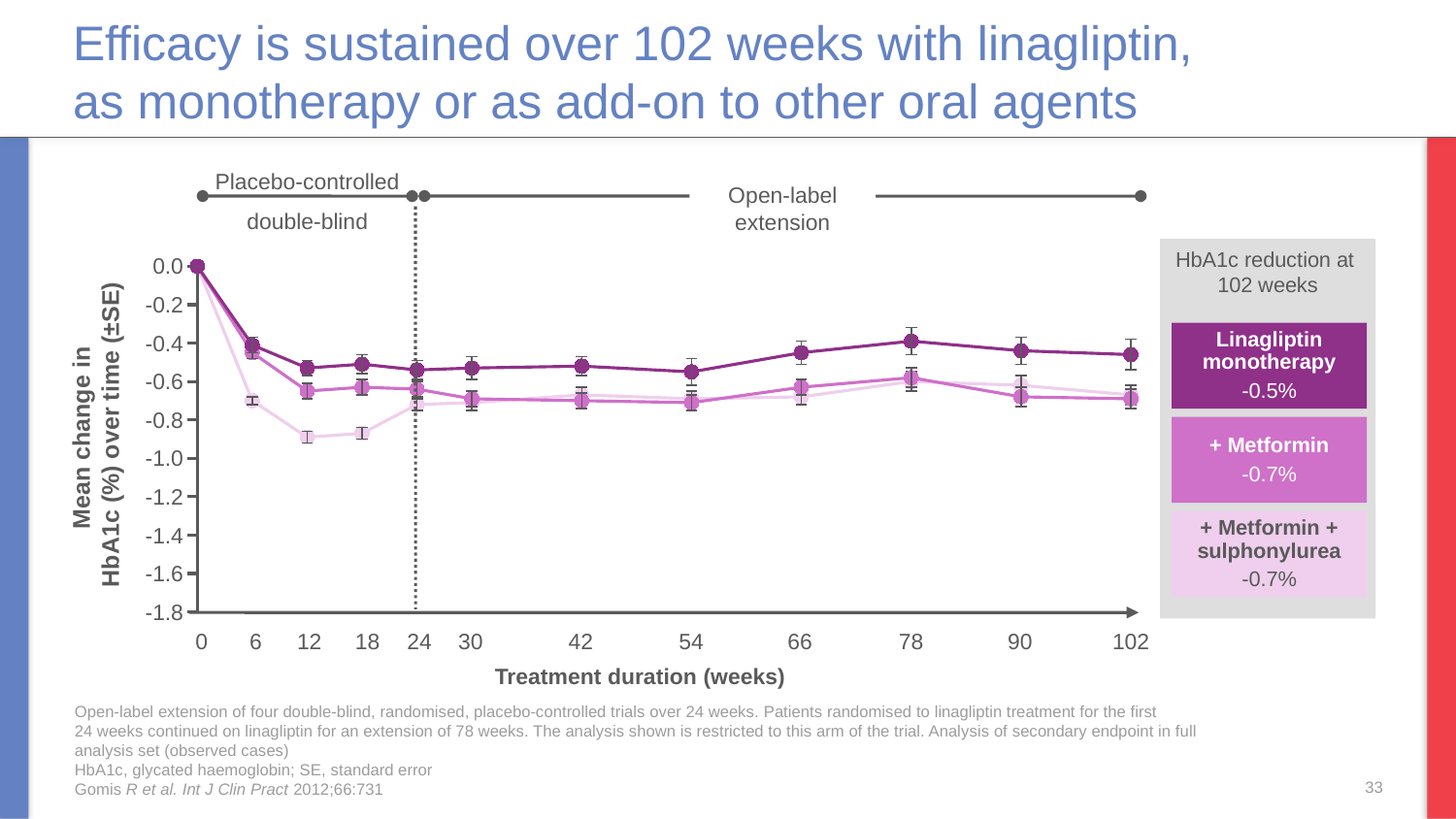
How many treatment series are plotted on the chart? 3 What is the label of the x axis? Treatment duration (weeks) What is the HbA1c reduction at 102 weeks for linagliptin + Metformin + sulphonylurea? -0.7% What is the difference between the HbA1c reduction at 102 weeks for linagliptin monotherapy and for + Metformin? 0.2% What is the HbA1c reduction at 102 weeks for linagliptin monotherapy? -0.5% Between week 0 and week 6, do the plotted values rise or fall? fall At week 12, is the mean change in HbA1c for + Metformin + sulphonylurea greater or less than -0.8? less What kind of chart is shown on the slide? line chart What is the HbA1c reduction at 102 weeks for linagliptin + Metformin? -0.7% At week 12, which series has the larger (less negative) mean change in HbA1c: linagliptin monotherapy or + Metformin + sulphonylurea? Linagliptin monotherapy At week 78, is the mean change in HbA1c for linagliptin monotherapy greater or less than -0.6? greater Which series shows the smallest HbA1c reduction at 102 weeks? Linagliptin monotherapy